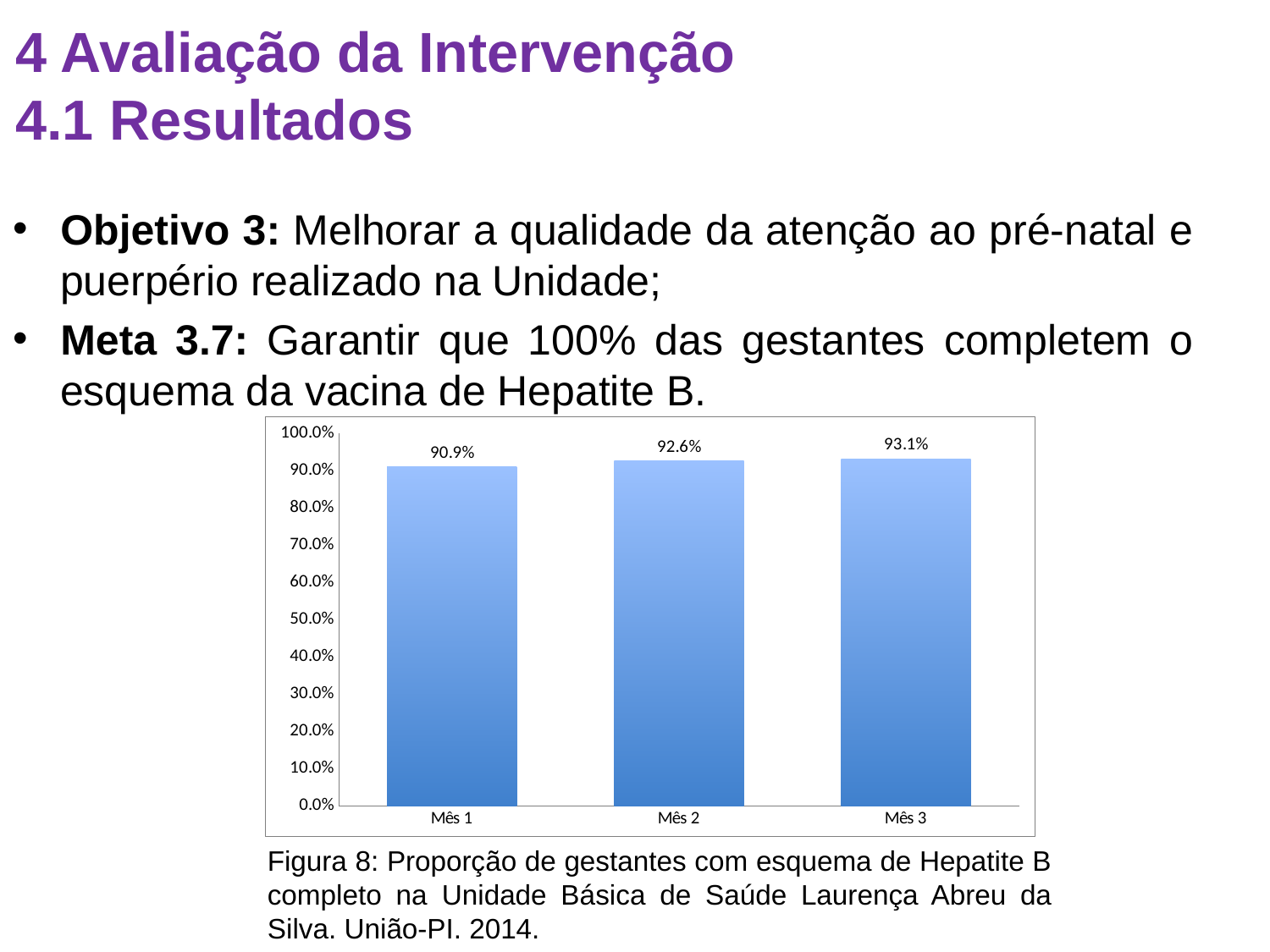
Which month has the highest value? Mês 3 What is the value for Mês 1? 90.9% Is the value for Mês 1 greater or less than 90.0%? greater What is the figure number given in the caption below the chart? Figura 8 What kind of chart is shown on the slide? Bar chart What is the value for Mês 2? 92.6% How many categories are shown on the x axis? 3 What is the difference between the values for Mês 2 and Mês 1? 1.7% Do the values rise or fall from Mês 1 to Mês 3? Rise What is the difference between the values for Mês 3 and Mês 1? 2.2% What is the value for Mês 3? 93.1% Which month has the lowest value? Mês 1